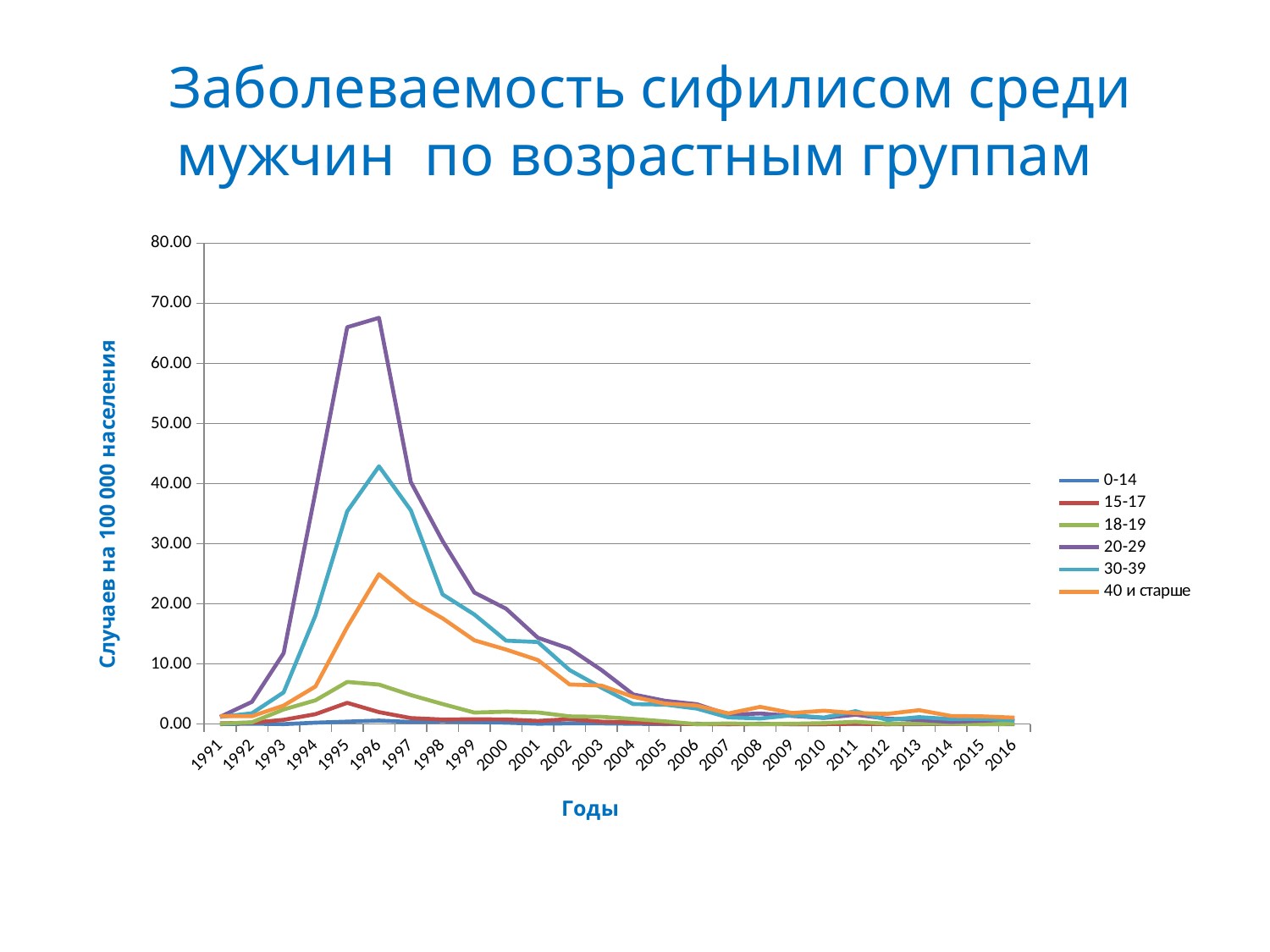
In which year does the 30-39 group reach its highest value? 1996 In 1996, which is larger: the value for 20-29 or the value for 30-39? 20-29 Is the value for the 40 и старше group in 1996 greater or less than 20? greater How many series does the legend list? 6 Is the value for the 20-29 group in 1996 greater or less than 60? greater How many years are plotted along the x axis? 26 Does the value for the 20-29 group rise or fall from 1996 to 2016? fall Is the peak value for the 18-19 group greater or less than 10? less What kind of chart is shown on the slide? line chart Which age group reaches the highest value on the chart? 20-29 What is the label of the y axis? Случаев на 100 000 населения